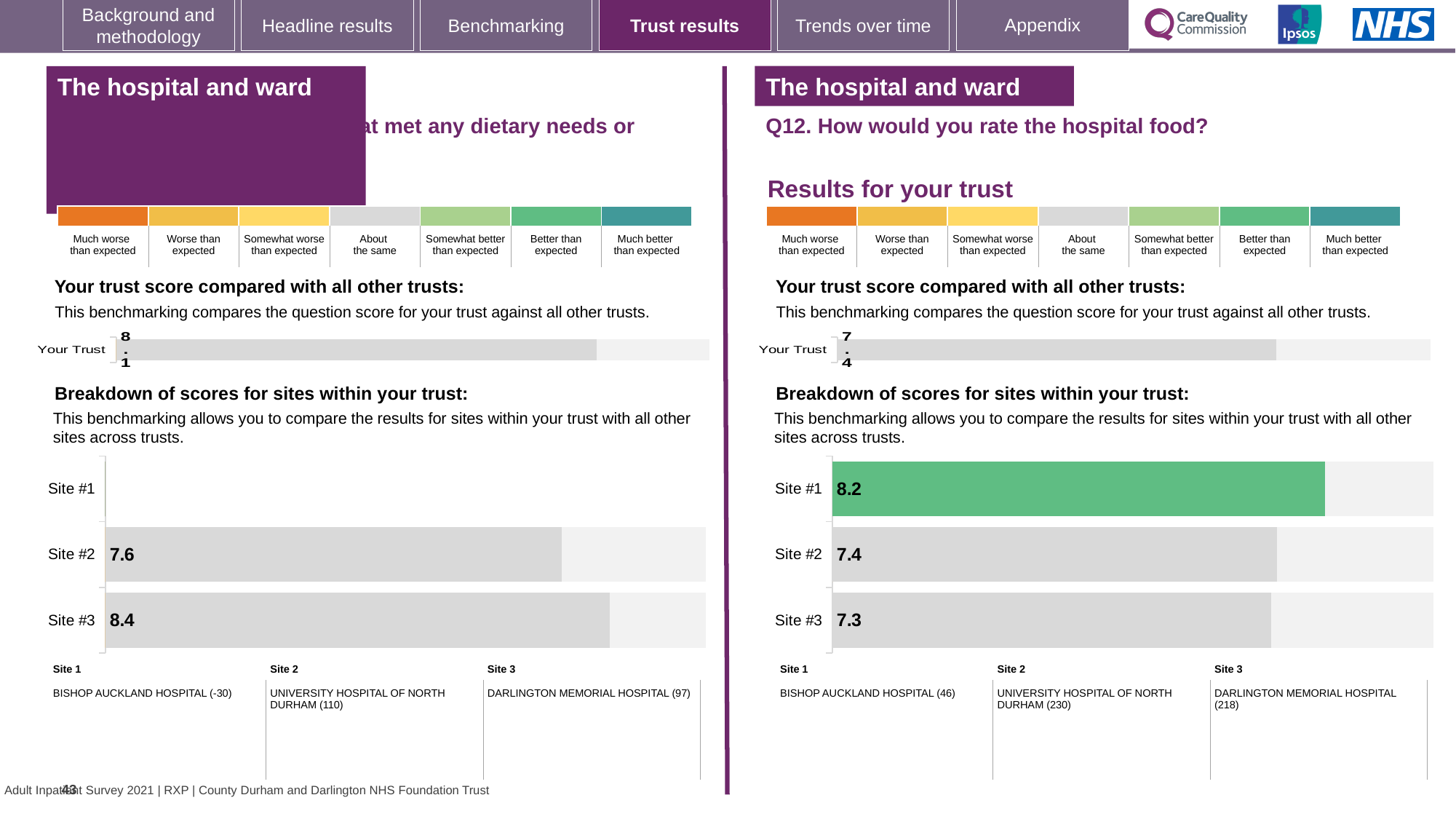
On the right-hand chart for Q12 (hospital food), what is the score for Site #3? 7.3 What type of chart is the right-hand site breakdown chart for Q12? Bar chart On the right-hand chart for Q12 (hospital food), what is the score for Site #1? 8.2 On the left-hand site breakdown chart, which is larger, the Site #2 score or the Site #3 score? Site #3 On the right-hand 'Your trust score compared with all other trusts' chart for Q12, what is the score for Your Trust? 7.4 On the left-hand 'Your trust score compared with all other trusts' chart, what is the score for Your Trust? 8.1 On the left-hand site breakdown chart, what is the score for Site #2? 7.6 On the left-hand site breakdown chart, what is the score for Site #3? 8.4 On the left-hand site breakdown chart, what is the difference between the Site #3 and Site #2 scores? 0.8 On the right-hand chart for Q12 (hospital food), which site has the highest score? Site #1 How many sites are listed on the right-hand site breakdown chart for Q12? 3 On the right-hand chart for Q12 (hospital food), what is the difference between the Site #1 and Site #3 scores? 0.9